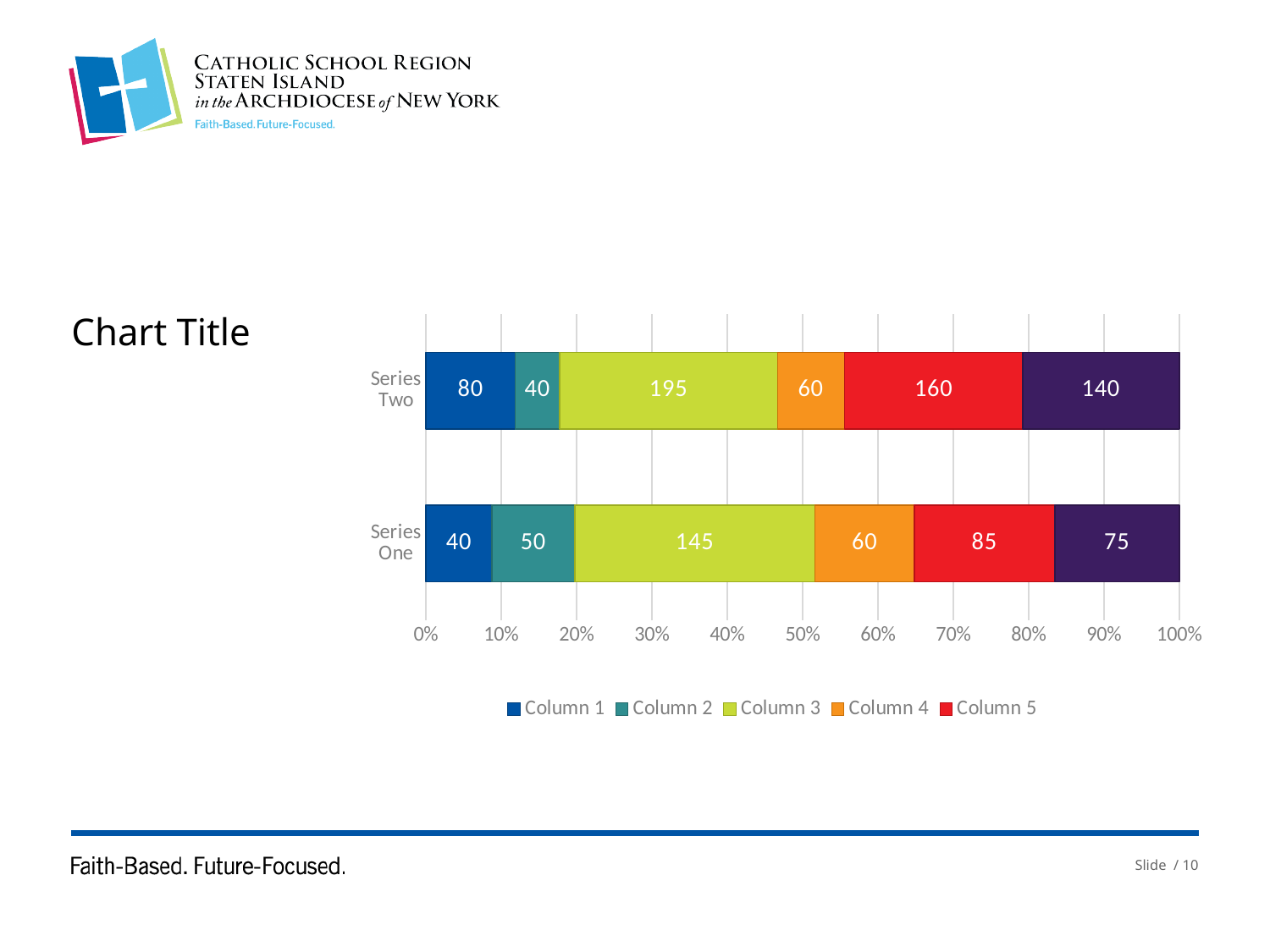
What is the title of the chart? Chart Title What is the value of Column 1 for Series One? 40 How many categories (bars) are shown on the chart? 2 What is the value of Column 4 for Series One? 60 What is the value of Column 5 for Series Two? 160 What is the difference between the Column 3 values for Series Two and Series One? 50 What kind of chart is shown on the slide? bar chart What is the value of Column 3 for Series Two? 195 How many series does the legend list? 5 Which legend entry has the largest value in the Series One bar? Column 3 Which legend entry has the smallest value in the Series Two bar? Column 2 Which has the larger Column 1 value, Series One or Series Two? Series Two